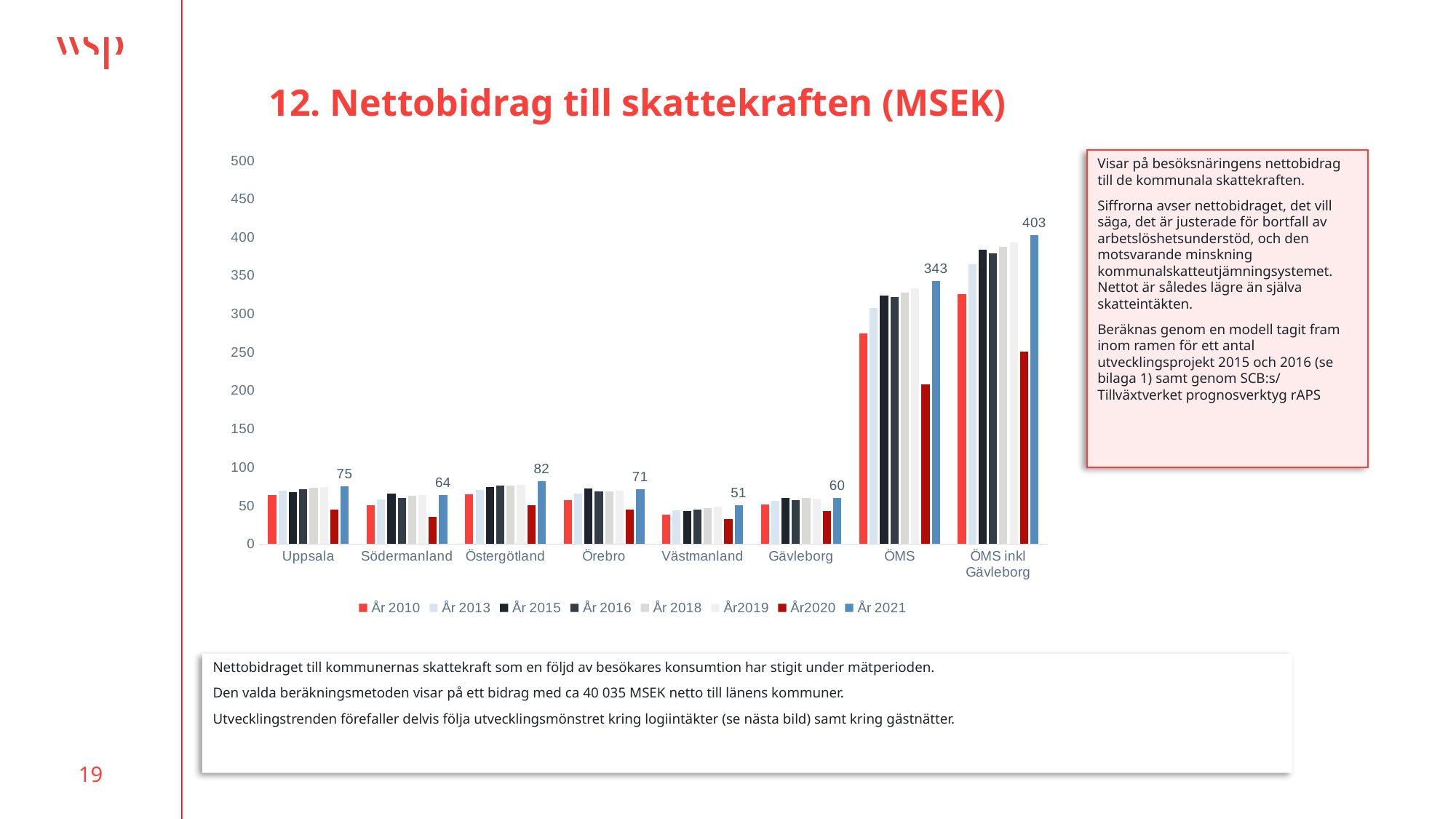
Which is larger for År 2021: Örebro or Gävleborg? Örebro What is the value for År 2021 in Östergötland? 82 Which category has the lowest value for År 2021? Västmanland Is the value for År 2010 in ÖMS greater or less than 250? greater Which category has the highest value for År 2021? ÖMS inkl Gävleborg How many categories are shown on the x axis? 8 What is the value for År 2021 in ÖMS inkl Gävleborg? 403 What is the value for År 2021 in Västmanland? 51 What is the value for År 2021 in Uppsala? 75 What is the difference between the År 2021 values for ÖMS inkl Gävleborg and ÖMS? 60 How many series does the legend list? 8 What kind of chart is shown on the slide? Bar chart